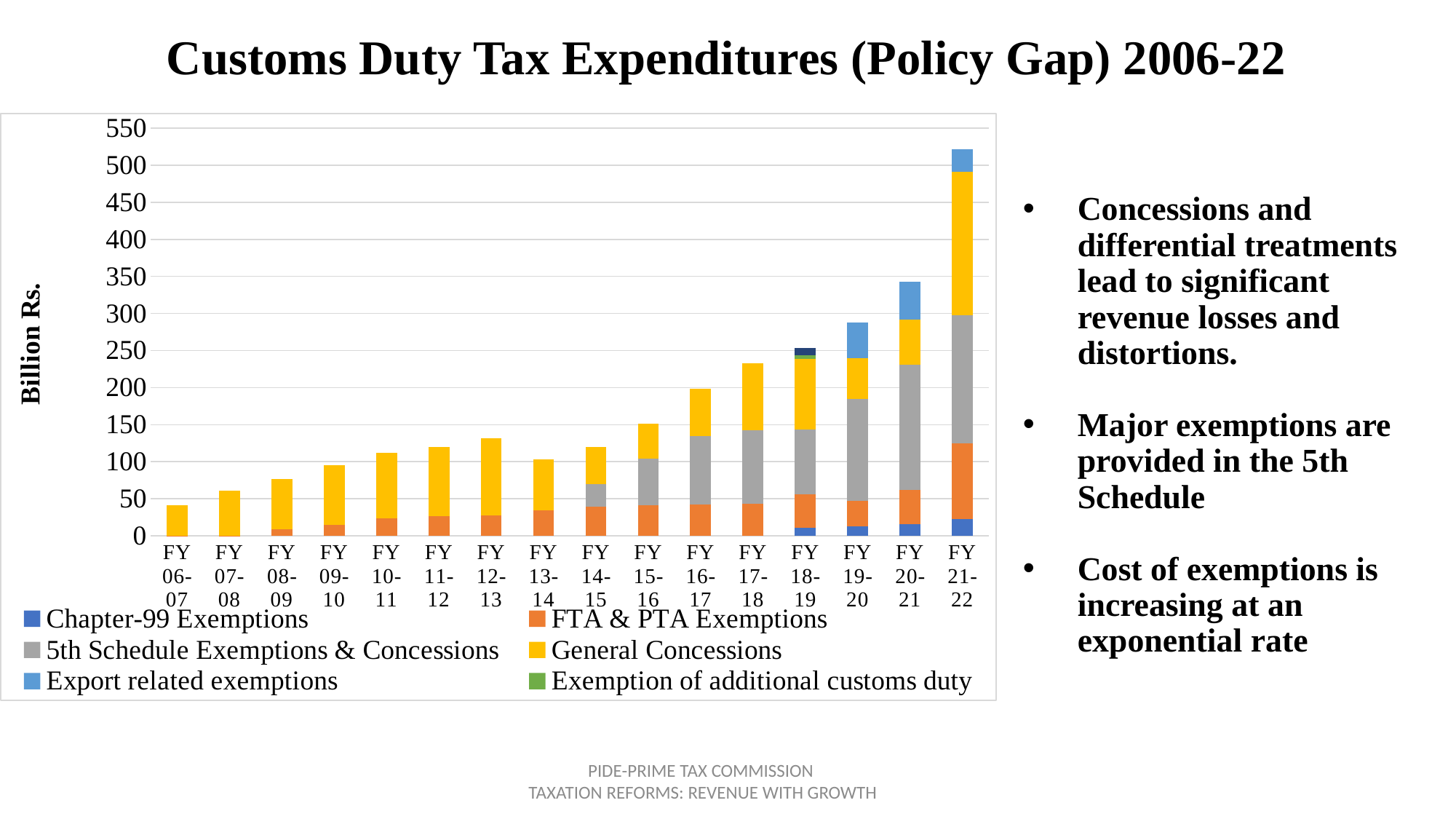
How many fiscal years are plotted along the x axis? 16 Which has the larger total, FY 12-13 or FY 13-14? FY 12-13 Which fiscal year has the lowest total customs duty tax expenditure? FY 06-07 Is the total value for FY 21-22 greater or less than 500? greater Which fiscal year has the highest total customs duty tax expenditure? FY 21-22 Is the total value for FY 20-21 greater or less than 300? greater How many series does the legend list? 6 Is the total value for FY 17-18 greater or less than 200? greater What kind of chart is shown on the slide? Stacked bar chart Do the total customs duty tax expenditures generally rise or fall from FY 06-07 to FY 21-22? Rise What is the label on the vertical axis of the chart? Billion Rs.